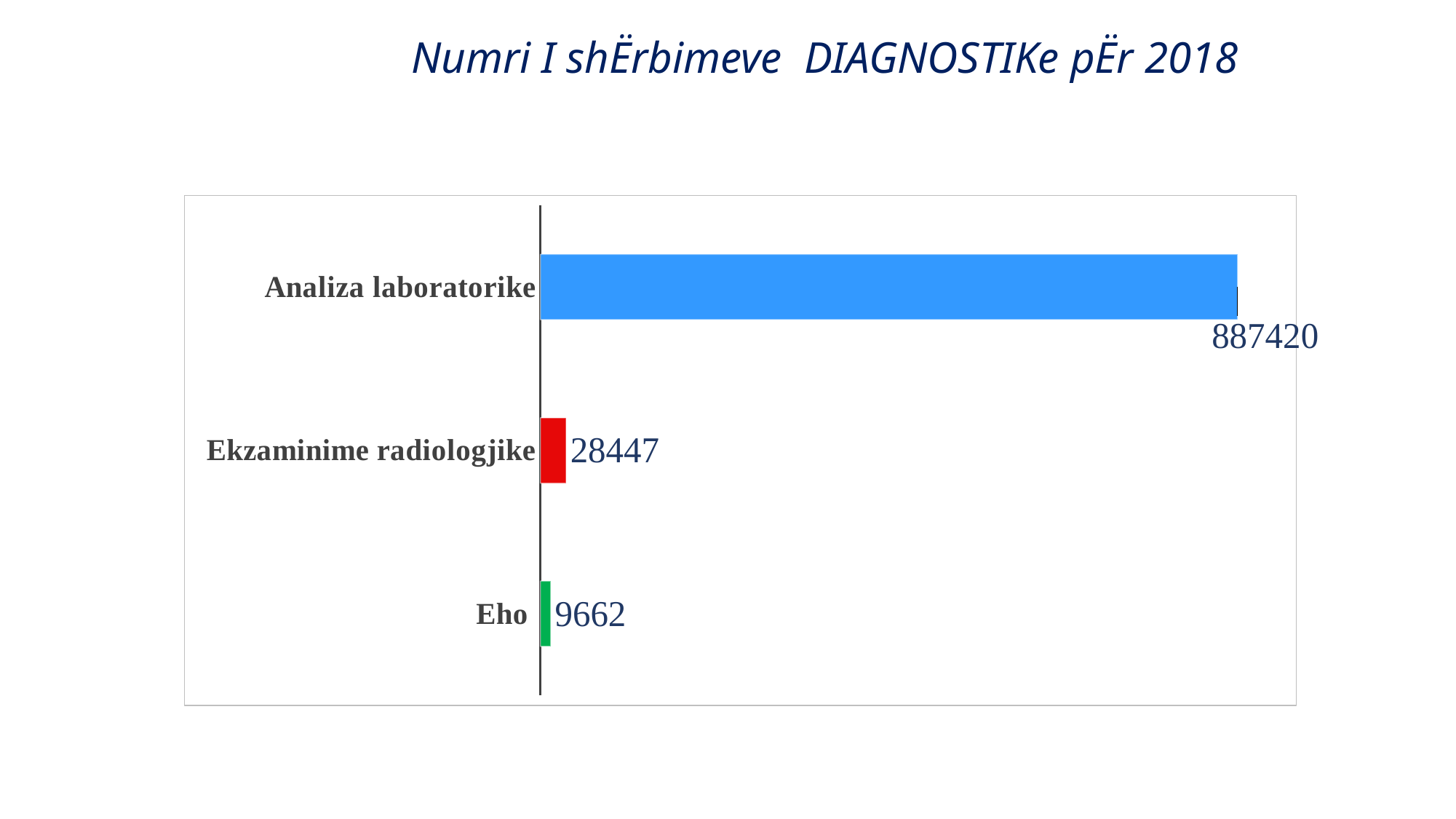
What is the value for Analiza laboratorike? 887420 What colour is the bar for Eho? Green How many categories are shown in the chart? 3 Which category has the lowest value? Eho What is the value for Ekzaminime radiologjike? 28447 What is the value for Eho? 9662 What is the difference between the values for Ekzaminime radiologjike and Eho? 18785 What is the title of the slide? Numri I shËrbimeve DIAGNOSTIKe pËr 2018 What is the difference between the values for Analiza laboratorike and Ekzaminime radiologjike? 858973 Which is larger, the value for Ekzaminime radiologjike or the value for Eho? Ekzaminime radiologjike What kind of chart is shown on the slide? Bar chart Which category has the highest value? Analiza laboratorike